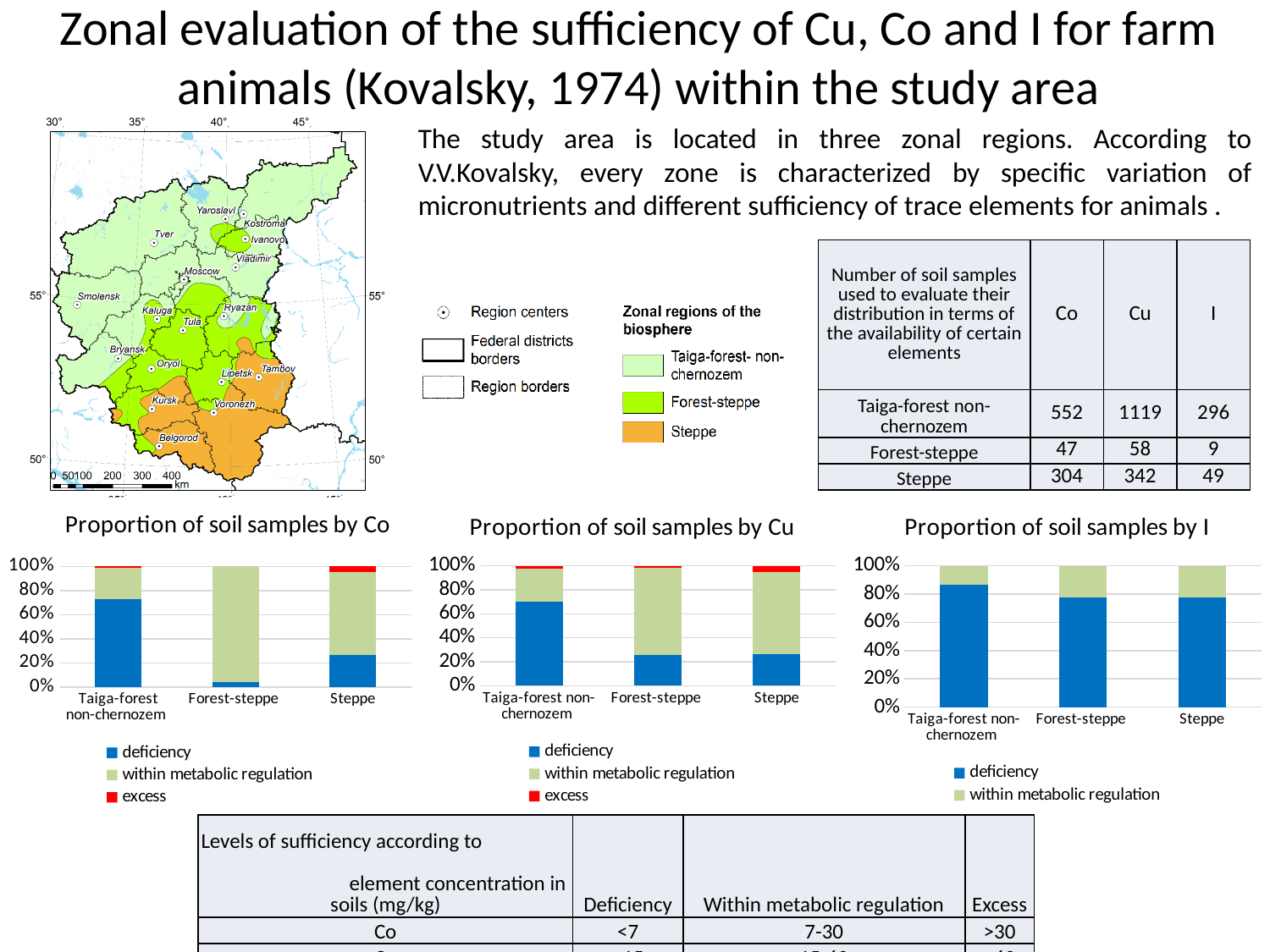
In 'Proportion of soil samples by Co', is the deficiency share for Taiga-forest non-chernozem greater or less than 60%? greater In 'Proportion of soil samples by Co', which category has the lowest deficiency share? Forest-steppe What kind of chart is 'Proportion of soil samples by Co'? bar chart How many series does the legend of 'Proportion of soil samples by Co' list? 3 In 'Proportion of soil samples by Cu', is the deficiency share for Steppe greater or less than 40%? less How many categories are shown on the x axis of 'Proportion of soil samples by Cu'? 3 In 'Proportion of soil samples by Cu', what colour represents the 'excess' series? red In 'Proportion of soil samples by Co', is the deficiency share for Forest-steppe greater or less than 20%? less How many series does the legend of 'Proportion of soil samples by I' list? 2 In 'Proportion of soil samples by Cu', which has the larger deficiency share: Taiga-forest non-chernozem or Forest-steppe? Taiga-forest non-chernozem In 'Proportion of soil samples by Co', which category has the highest deficiency share? Taiga-forest non-chernozem